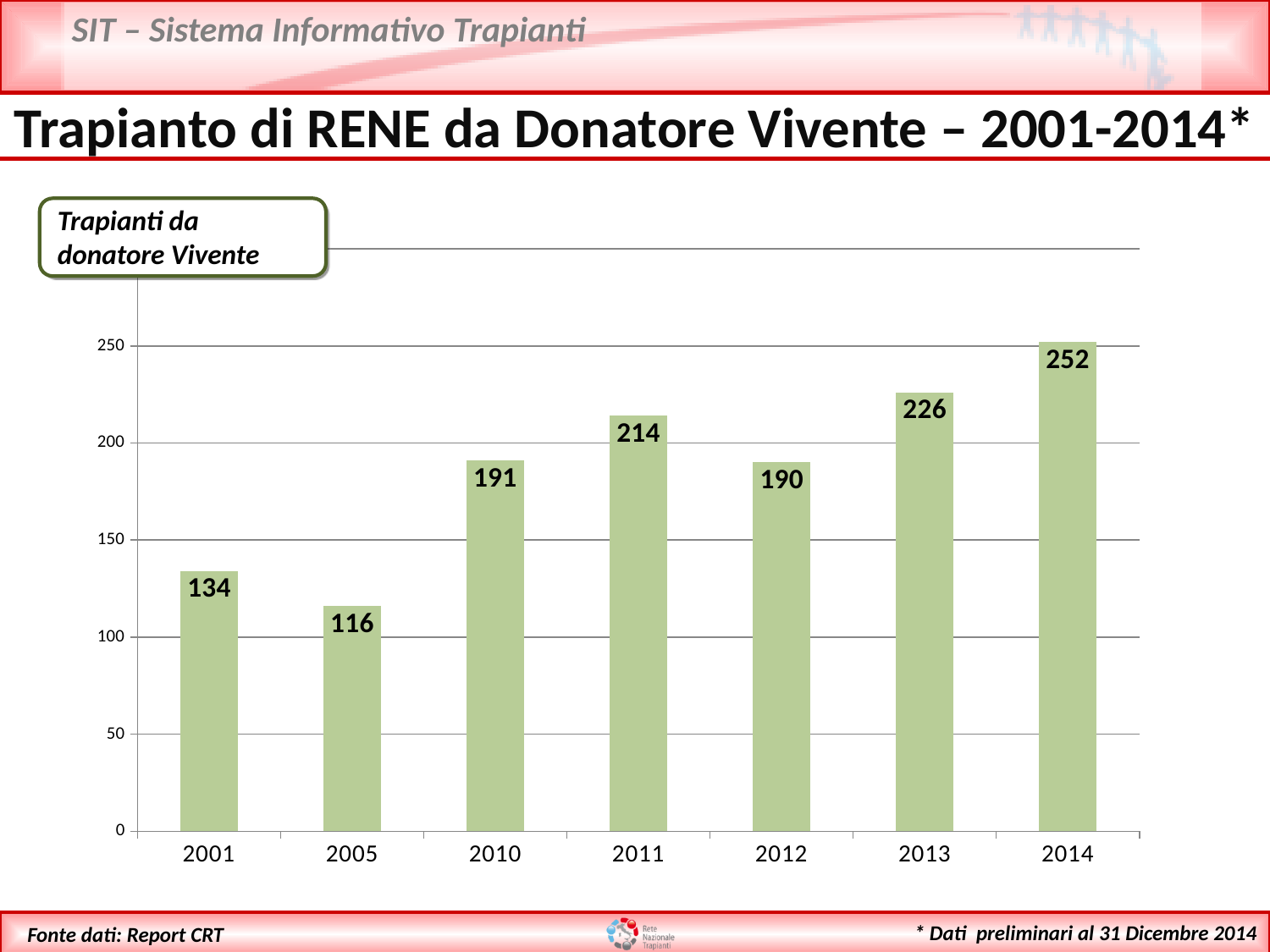
Which year has the lowest value? 2005 What is the value for 2014? 252 What is the value for 2005? 116 Which year has the highest value? 2014 What is the difference between the values for 2014 and 2013? 26 How many years are shown on the x axis? 7 What is the value for 2010? 191 Which is larger, the value for 2011 or the value for 2012? 2011 What kind of chart is shown on the slide? bar chart What is the label in the box at the top left of the chart? Trapianti da donatore Vivente Is the value for 2013 greater or less than 200? greater What is the difference between the values for 2001 and 2005? 18